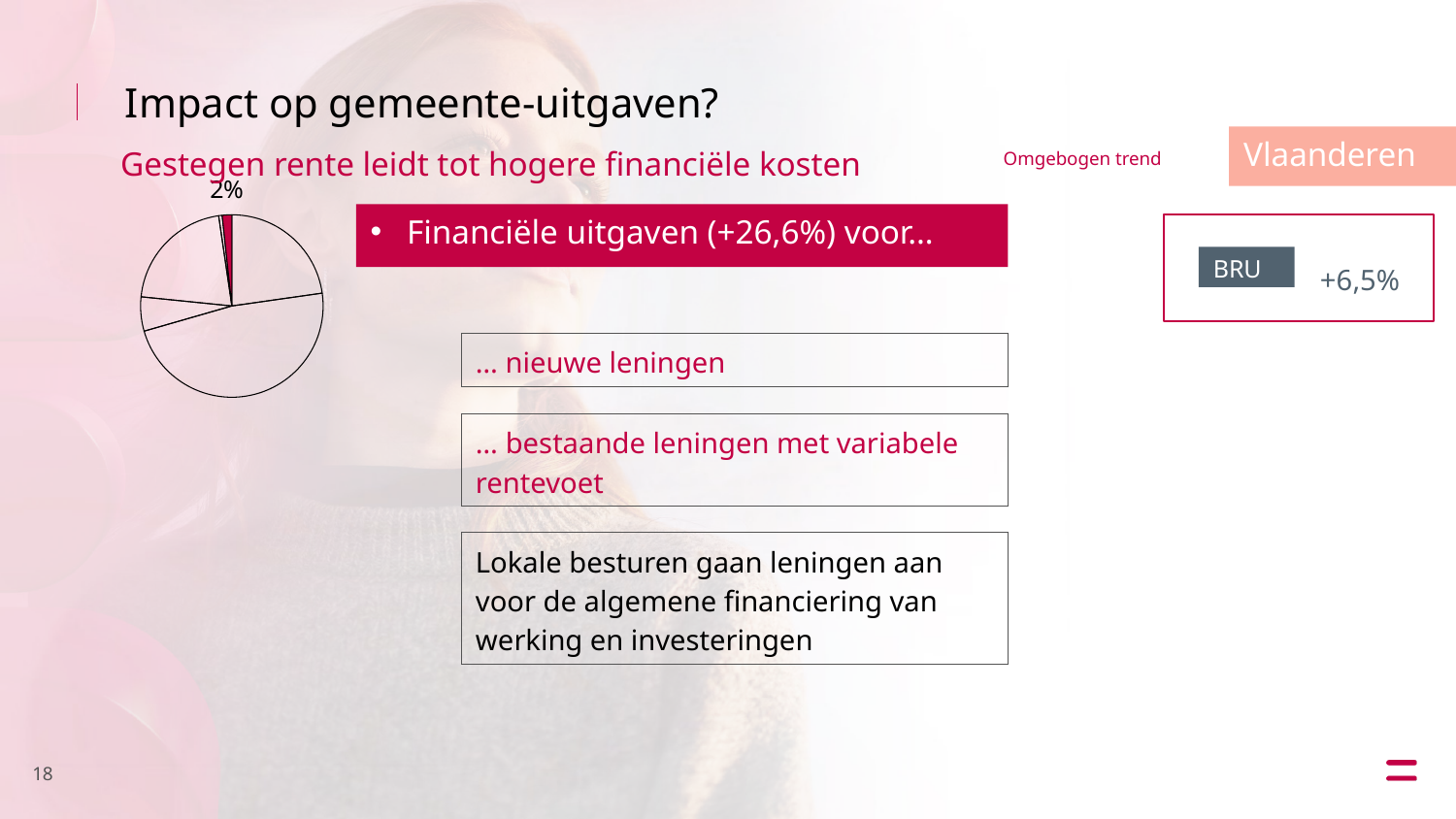
What value is printed as the data label on the pie chart? 2% What colour is the slice of the pie chart that carries the 2% label? red What share of the pie does the labelled red slice represent? 2% Is the labelled slice of the pie chart larger or smaller than the largest unlabelled slice? smaller Does the pie chart display a legend? No What kind of chart is shown on the left of the slide? pie chart